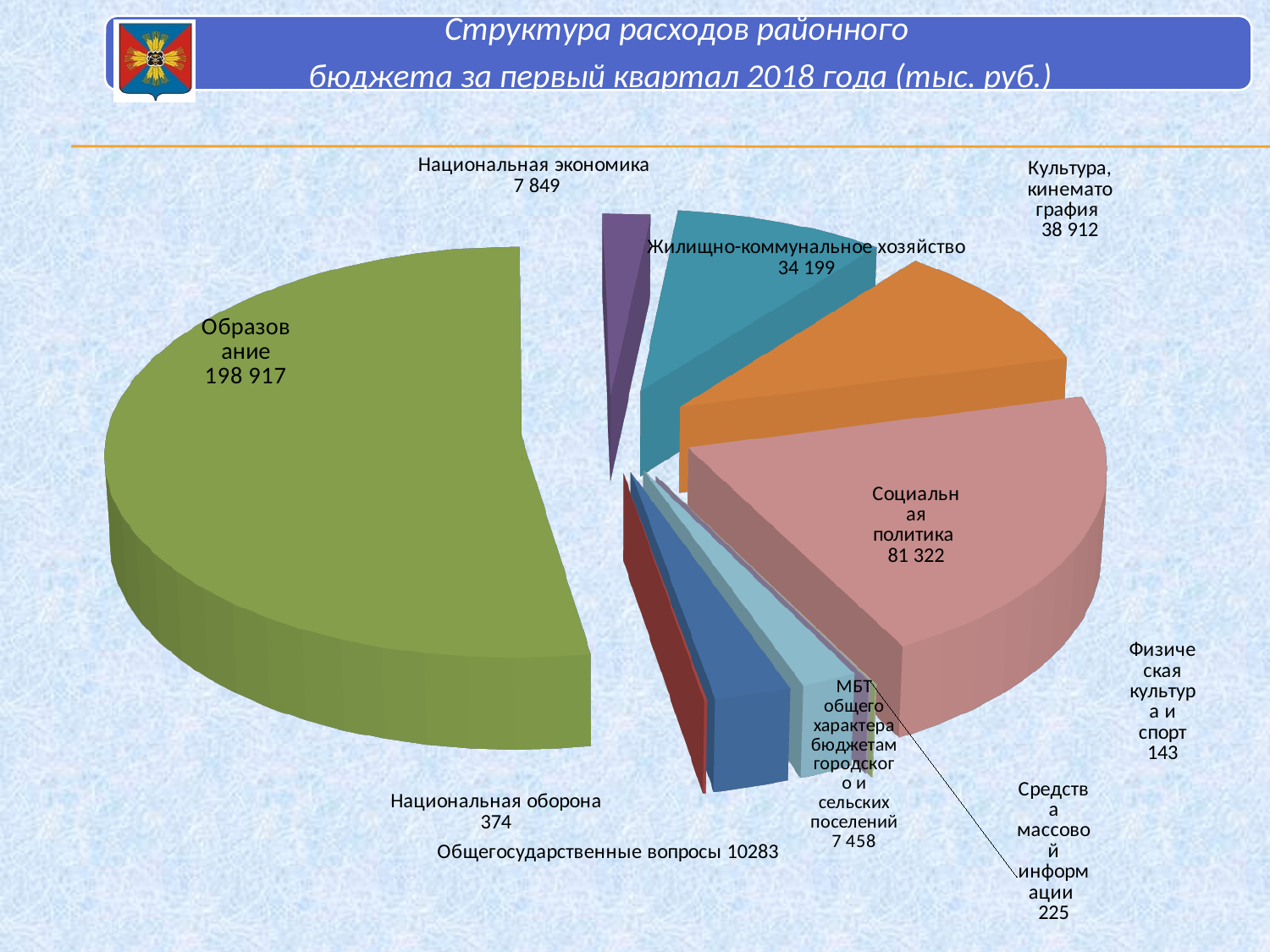
What is the title of the chart? Структура расходов районного бюджета за первый квартал 2018 года (тыс. руб.) What is the value for Образование? 198 917 What is the value for Социальная политика? 81 322 What is the value for Общегосударственные вопросы? 10283 What is the value for Национальная оборона? 374 What is the value for Жилищно-коммунальное хозяйство? 34 199 Which is larger: Культура, кинематография or Жилищно-коммунальное хозяйство? Культура, кинематография Which category has the smallest value? Физическая культура и спорт How many categories are shown in the pie chart? 10 Which category has the largest value? Образование What type of chart is shown on the slide? Pie chart What is the difference between Образование and Социальная политика? 117 595